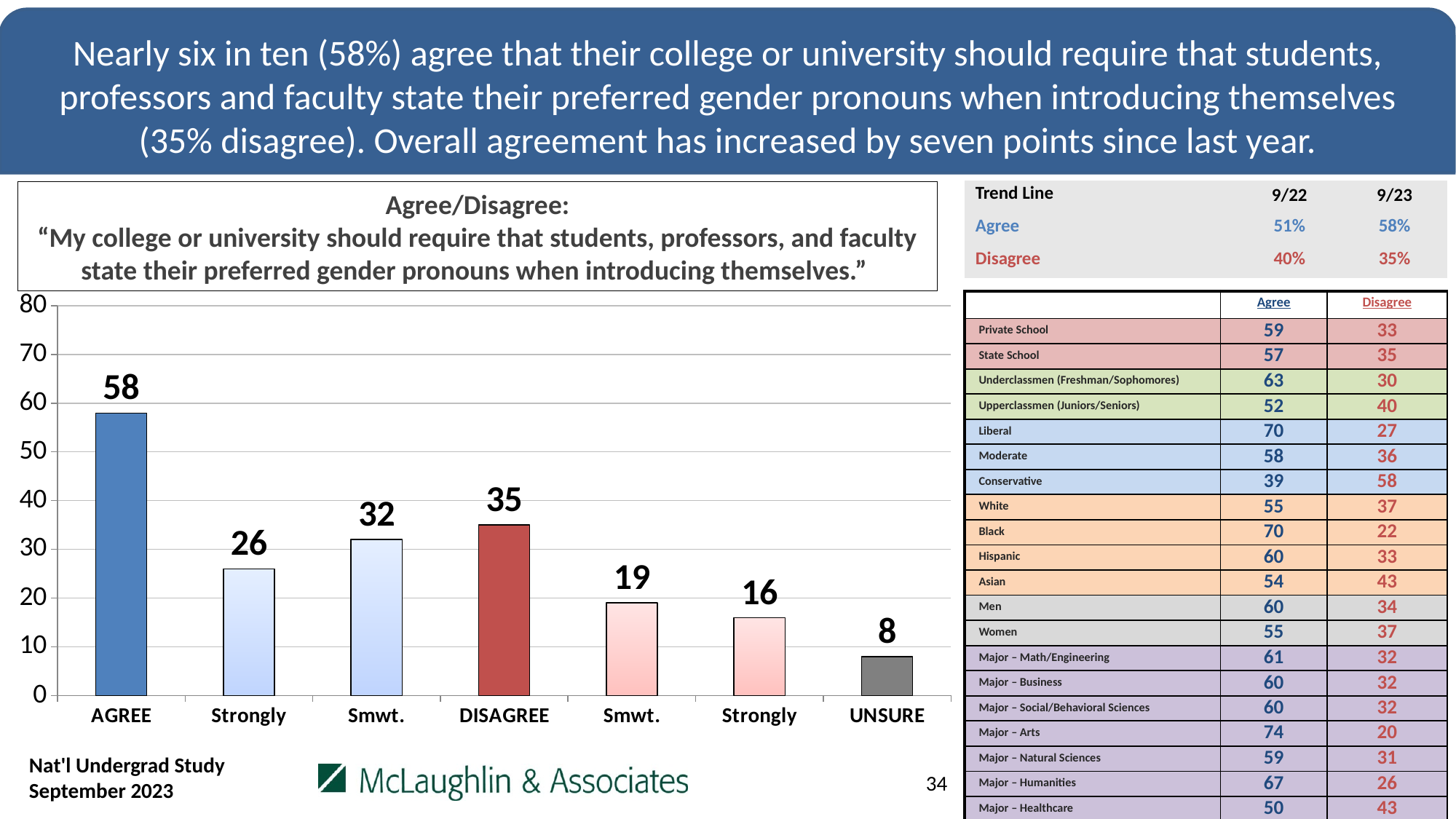
What colour is the DISAGREE bar? red What is the difference between the Smwt. agree bar (third from left) and the Smwt. disagree bar (third from right)? 13 How many bars are shown in the chart? 7 Is the value of the DISAGREE bar greater or less than 40? less Which is larger, the Strongly agree bar (second from left) or the Strongly disagree bar (second from right)? Strongly agree (26) Which category has the highest bar? AGREE What is the value of the UNSURE bar? 8 What is the value of the DISAGREE bar? 35 Which category has the lowest bar? UNSURE What type of chart is shown on the slide? bar chart What is the difference between the AGREE and DISAGREE bars? 23 What is the value of the AGREE bar? 58